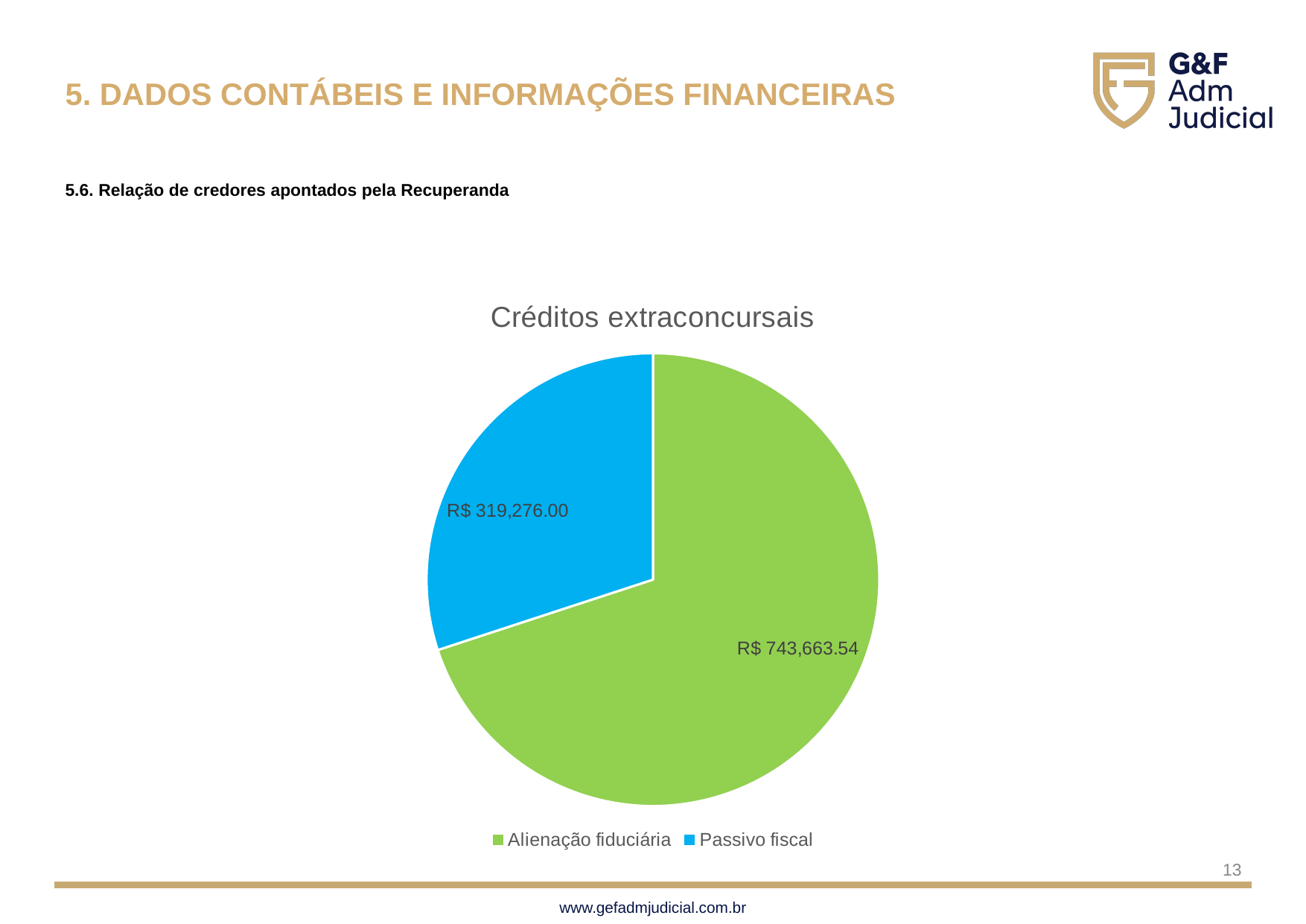
How many categories does the pie chart show? 2 What is the value for Passivo fiscal? R$ 319,276.00 Which category has the smallest slice of the pie? Passivo fiscal Which is larger, Alienação fiduciária or Passivo fiscal? Alienação fiduciária What is the title of the chart? Créditos extraconcursais What is the total of the two slices in the pie chart? R$ 1,062,939.54 What type of chart is shown on the slide? pie chart Which category has the largest slice of the pie? Alienação fiduciária To the nearest whole percent, what share of the pie does Alienação fiduciária represent? 70% What colour is the Passivo fiscal slice? blue What is the difference between the value for Alienação fiduciária and the value for Passivo fiscal? R$ 424,387.54 What is the value for Alienação fiduciária? R$ 743,663.54